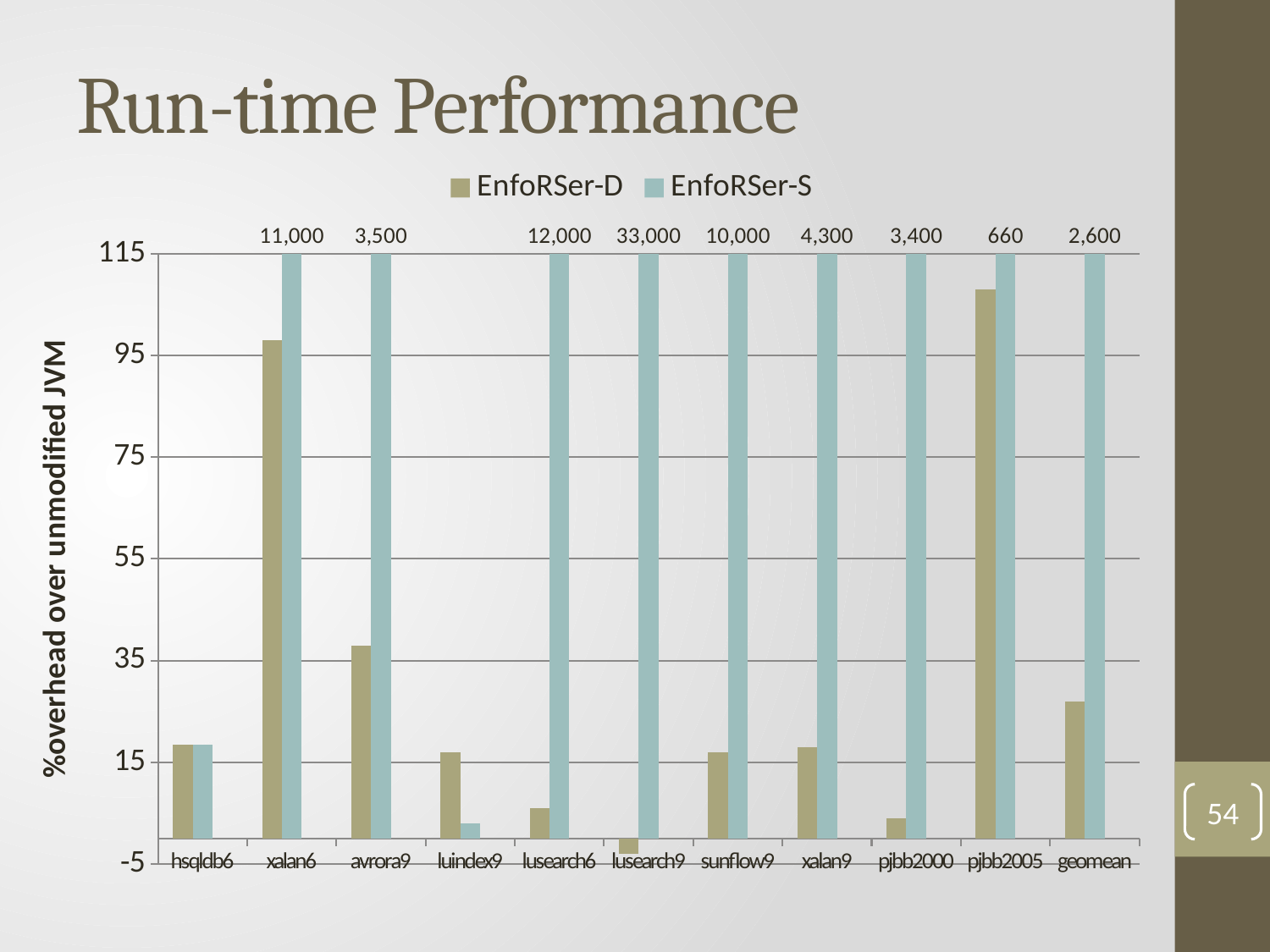
How many series does the legend list? 2 What is the EnfoRSer-S value printed for lusearch9? 33,000 What is the label on the y axis? %overhead over unmodified JVM Is the EnfoRSer-D value for pjbb2005 greater or less than 95? greater What is the EnfoRSer-S value printed for pjbb2005? 660 Which has the larger printed EnfoRSer-S value, xalan6 or sunflow9? xalan6 How many benchmark categories are shown on the x axis? 11 What is the EnfoRSer-S value printed for xalan6? 11,000 What kind of chart is shown on the slide? bar chart Which category has the lowest printed EnfoRSer-S value? pjbb2005 What is the difference between the printed EnfoRSer-S values for lusearch9 and lusearch6? 21,000 Which category has the highest printed EnfoRSer-S value? lusearch9